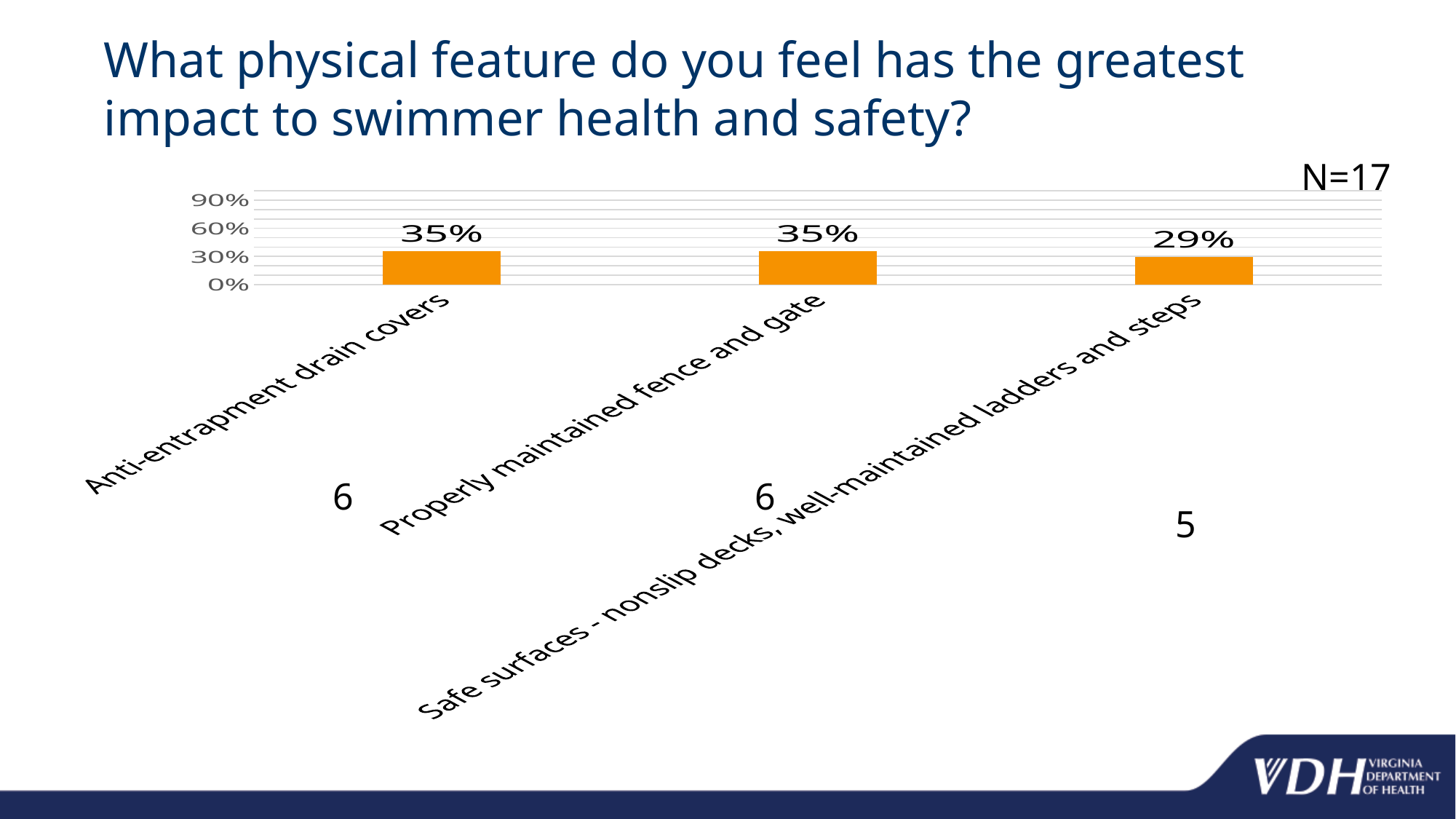
Which category has the lowest percentage? Safe surfaces - nonslip decks, well-maintained ladders and steps What is the difference in percentage points between Anti-entrapment drain covers and Safe surfaces - nonslip decks, well-maintained ladders and steps? 6 percentage points What percentage is shown for Anti-entrapment drain covers? 35% Is the value for Safe surfaces - nonslip decks, well-maintained ladders and steps greater or less than 60%? less What percentage is shown for Properly maintained fence and gate? 35% Is the value for Anti-entrapment drain covers greater or less than 30%? greater How many categories are shown in the chart? 3 What kind of chart is shown on the slide? Bar chart What percentage is shown for Safe surfaces - nonslip decks, well-maintained ladders and steps? 29% Which is larger, the value for Properly maintained fence and gate or the value for Safe surfaces - nonslip decks, well-maintained ladders and steps? Properly maintained fence and gate What is the highest value shown on the vertical axis? 90% What is the total number of respondents (N) shown on the slide? N=17